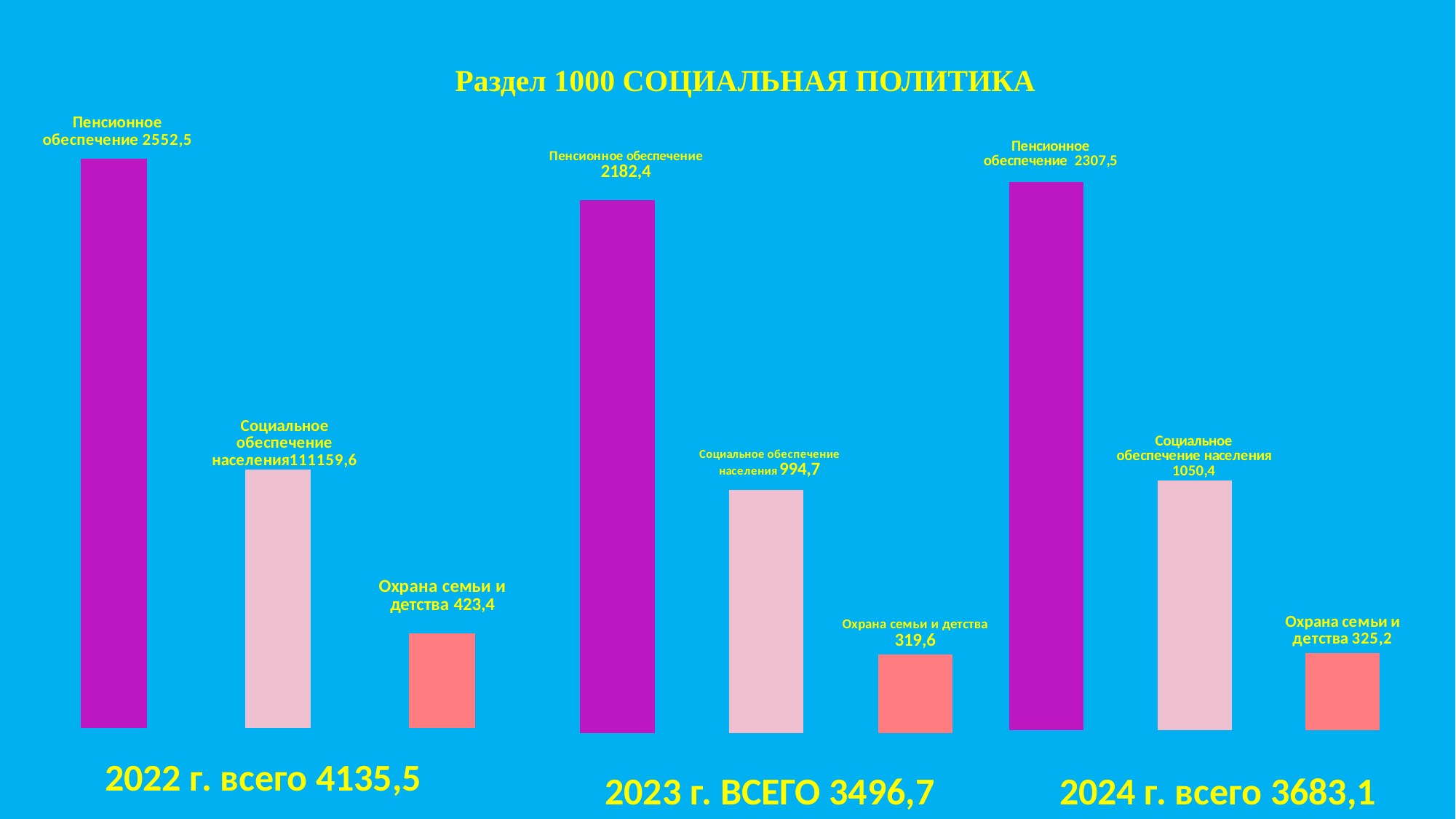
On the 2022 chart, what is the value for Пенсионное обеспечение? 2552,5 On the 2024 chart, which category has the highest value? Пенсионное обеспечение Which is larger: Пенсионное обеспечение on the 2023 chart or Пенсионное обеспечение on the 2024 chart? 2024 (2307,5) What kind of chart is used for each year on this slide? Bar chart On the 2024 chart, what is the difference between Пенсионное обеспечение and Социальное обеспечение населения? 1257,1 On the 2023 chart, what is the value for Охрана семьи и детства? 319,6 How many bars are on the 2022 chart? 3 On the 2023 chart, what is the value for Социальное обеспечение населения? 994,7 What is the total shown for 2023 on the slide? 3496,7 What is the title of the slide? Раздел 1000 СОЦИАЛЬНАЯ ПОЛИТИКА On the 2023 chart, which category has the lowest value? Охрана семьи и детства On the 2024 chart, what is the value for Охрана семьи и детства? 325,2